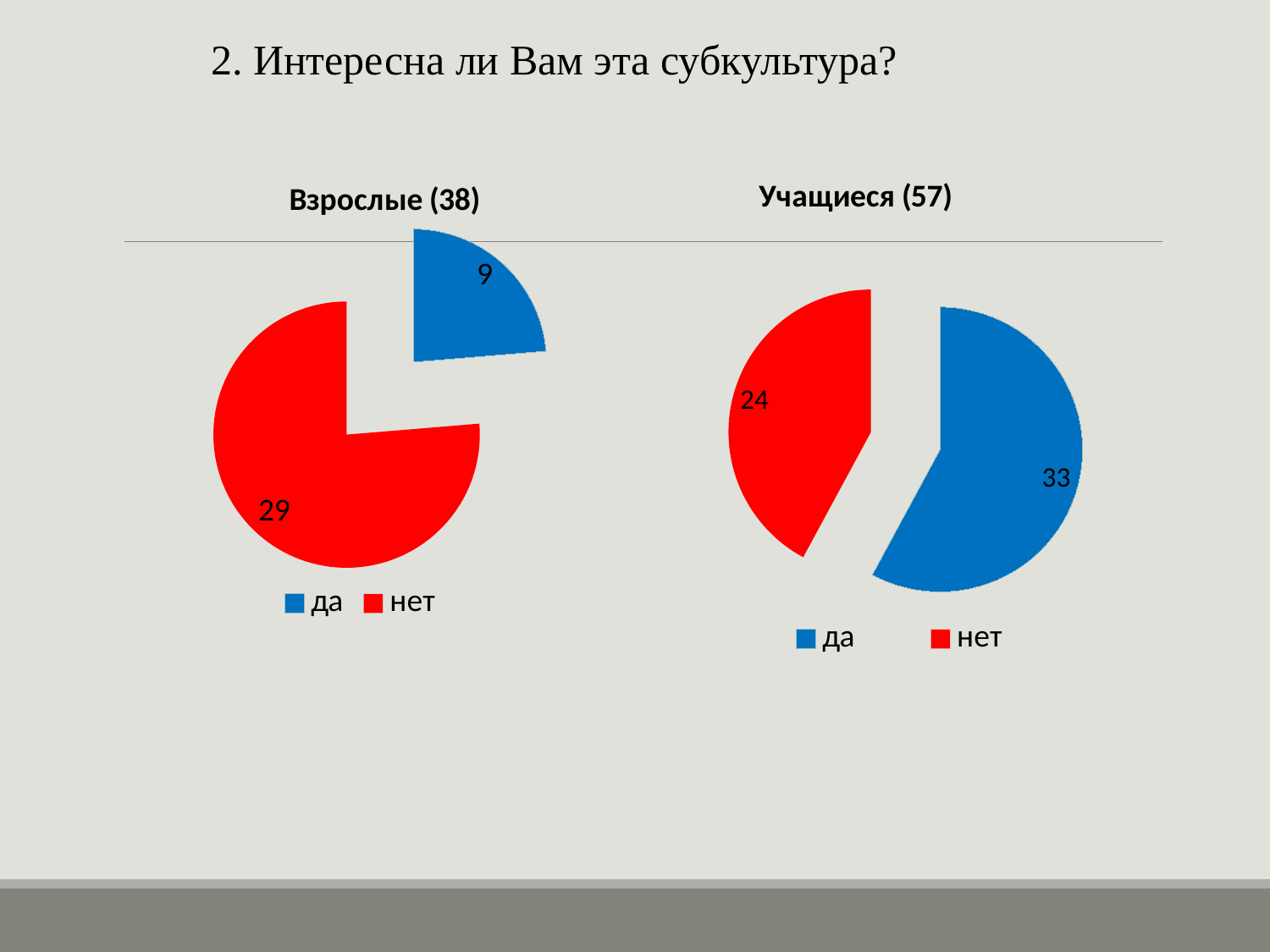
In the chart titled "Взрослые (38)", which category has the largest slice? нет In the chart titled "Учащиеся (57)", what is the value for "нет"? 24 How many categories does the legend of the chart titled "Взрослые (38)" list? 2 In the chart titled "Учащиеся (57)", what is the difference between the values for "да" and "нет"? 9 In the chart titled "Взрослые (38)", what colour is the "нет" slice? red What type of chart is the chart titled "Учащиеся (57)"? pie chart In the chart titled "Взрослые (38)", what is the difference between the values for "нет" and "да"? 20 In the chart titled "Учащиеся (57)", which category has the smallest slice? нет Is the value for "да" larger in the chart titled "Взрослые (38)" or in the chart titled "Учащиеся (57)"? Учащиеся (57) In the chart titled "Взрослые (38)", what is the value for "да"? 9 In the chart titled "Взрослые (38)", what is the value for "нет"? 29 In the chart titled "Учащиеся (57)", what is the value for "да"? 33